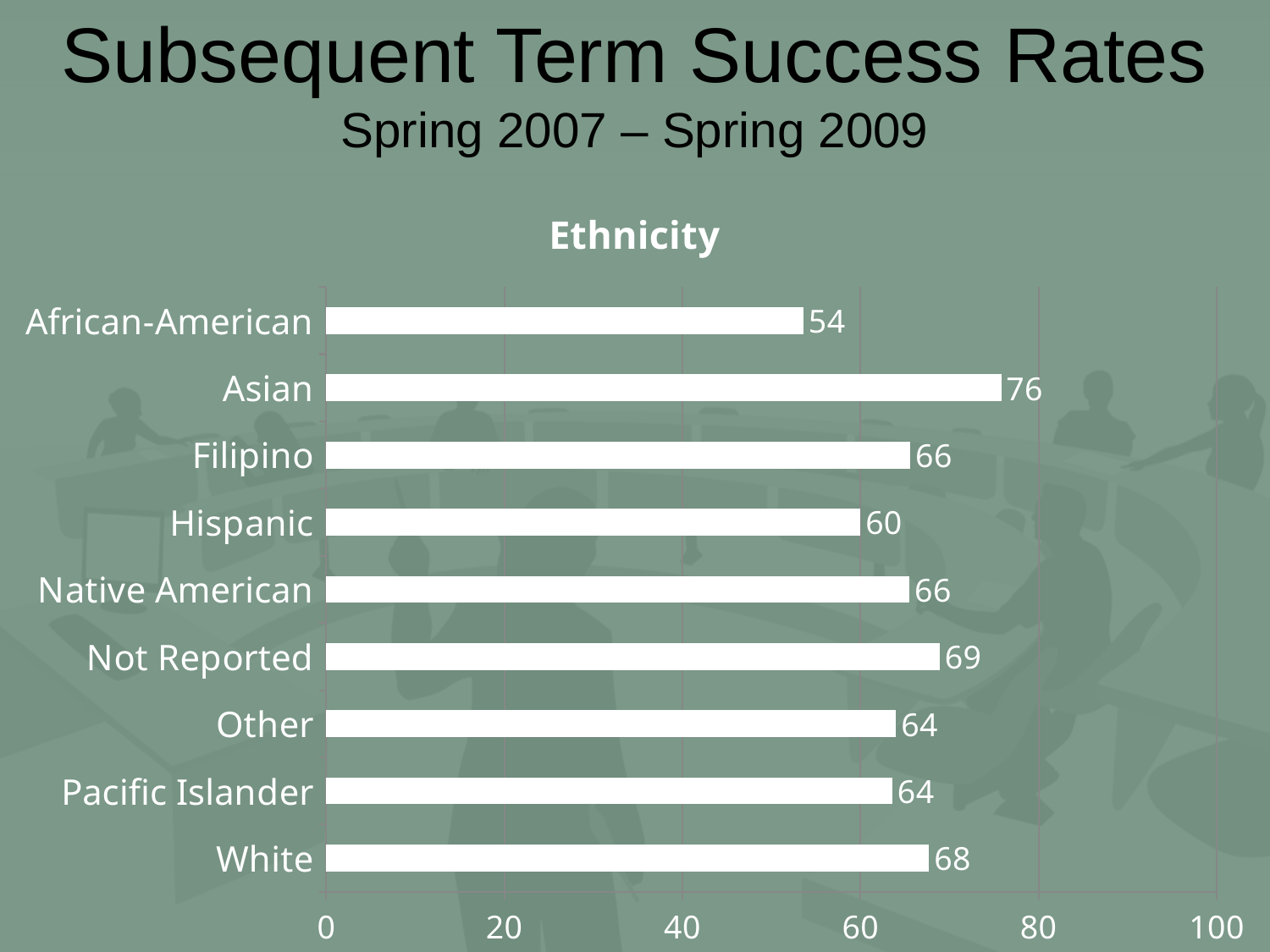
Is the value for Pacific Islander greater or less than 80? less What is the value for White? 68 What is the value for Asian? 76 What is the value for African-American? 54 Which is larger, the value for Hispanic or the value for Filipino? Filipino How many categories are shown in the chart? 9 What is the difference between the values for Asian and African-American? 22 Which category has the highest value? Asian Which category has the lowest value? African-American What is the value for Not Reported? 69 What is the title of the chart? Ethnicity What kind of chart is shown on the slide? bar chart